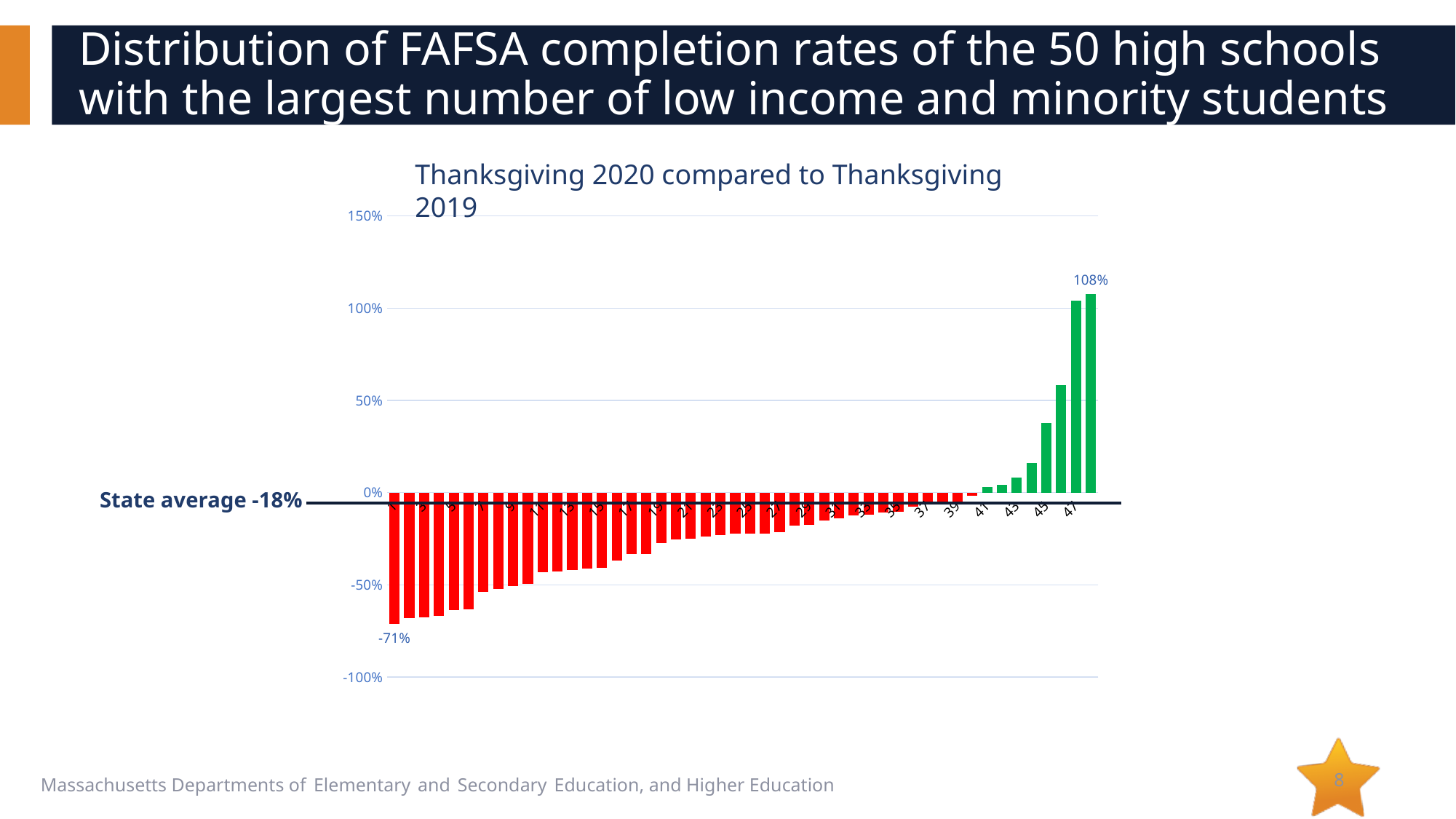
What is the state average marked on the chart? -18% Which is larger, the value of the leftmost bar or the value of the rightmost bar? the rightmost bar What is the difference between the highest value (108%) and the lowest value (-71%) in the chart? 179 percentage points What colour are the bars with negative values? red Is the highest value in the chart greater or less than 100%? greater What is the lowest value shown in the chart? -71% Is the lowest value in the chart greater or less than -50%? less What kind of chart is shown on the slide? bar chart What is the title of the chart? Thanksgiving 2020 compared to Thanksgiving 2019 What is the highest value shown in the chart? 108% How many high schools are represented by bars in the chart? 48 Do the bar values rise or fall moving from left to right along the x axis? rise